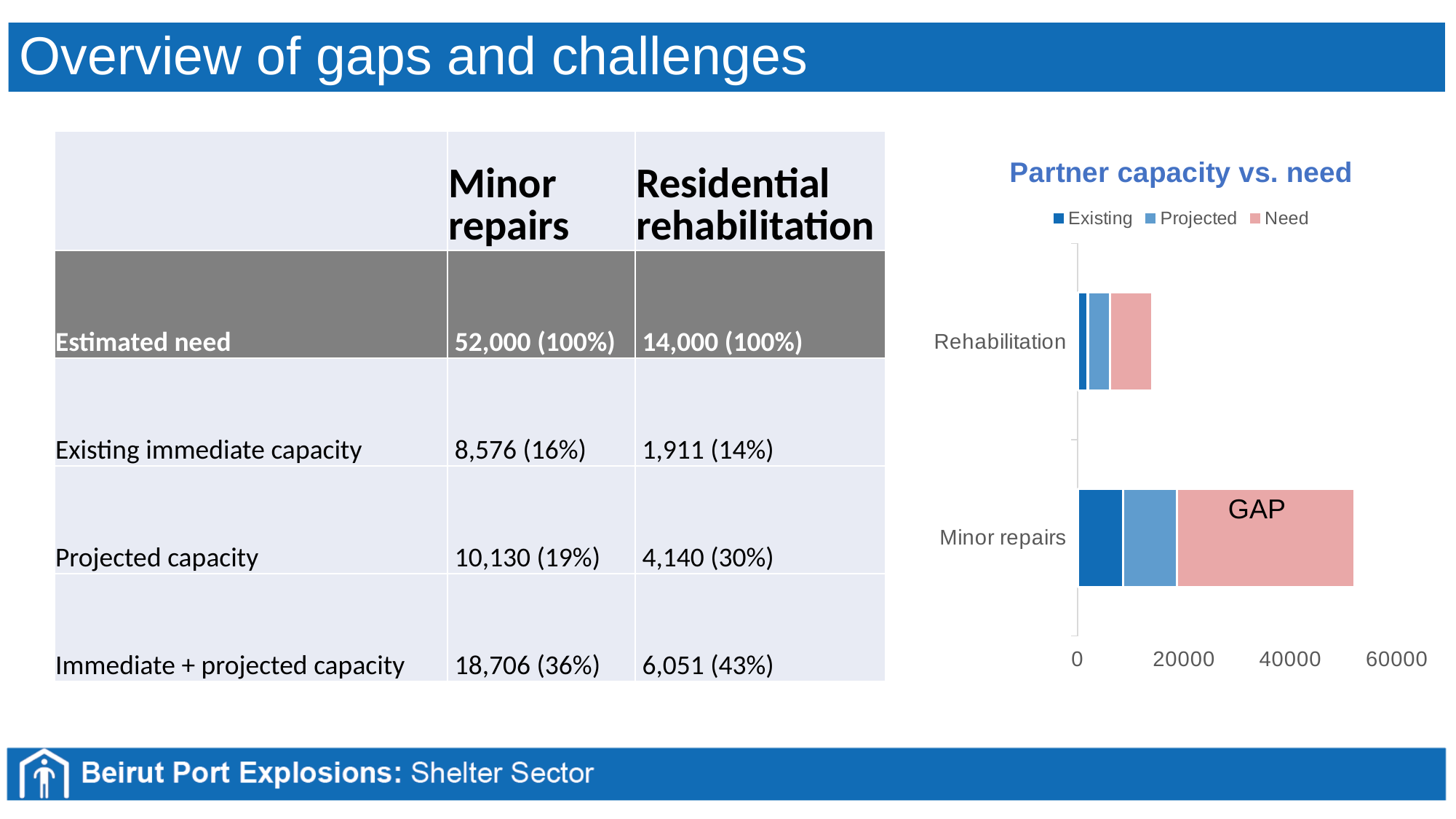
What kind of chart is shown under the title "Partner capacity vs. need"? bar chart Which category has the shortest total stacked bar in the "Partner capacity vs. need" chart? Rehabilitation Which category has the longer total stacked bar in the "Partner capacity vs. need" chart, Minor repairs or Rehabilitation? Minor repairs What word is written inside the Need segment of the Minor repairs bar? GAP Is the total length of the Minor repairs stacked bar greater or less than 40000? greater How many categories are plotted on the y axis of the "Partner capacity vs. need" chart? 2 How many series does the legend of the "Partner capacity vs. need" chart list? 3 Is the total length of the Rehabilitation stacked bar greater or less than 20000? less What is the title of the chart on the right of the slide? Partner capacity vs. need What is the highest value shown on the x axis of the "Partner capacity vs. need" chart? 60000 Is the Existing segment of the Minor repairs bar greater or less than 20000? less